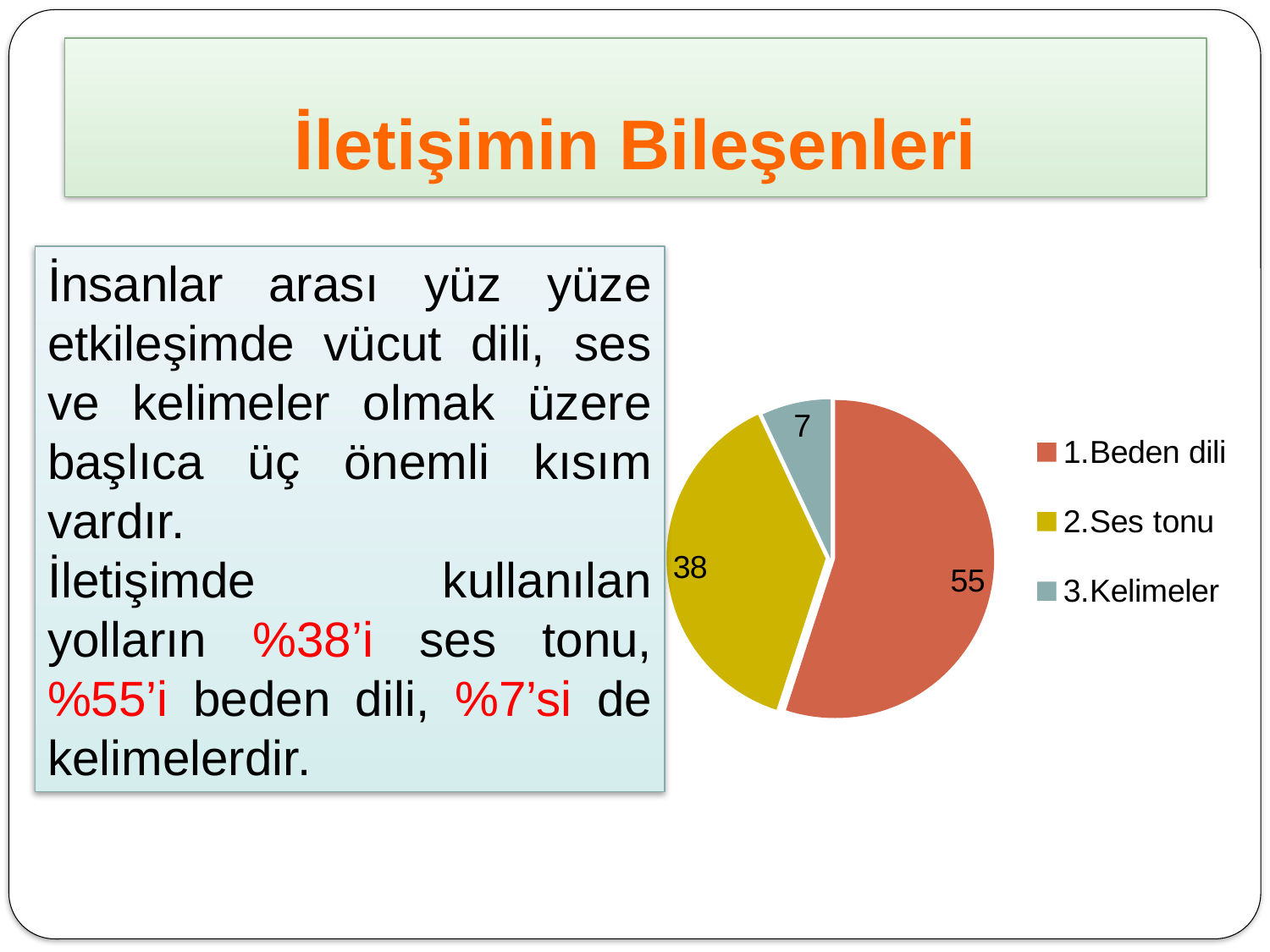
What is the difference between the values for 2.Ses tonu and 3.Kelimeler? 31 Which category has the largest slice in the pie chart? 1.Beden dili What is the value for 3.Kelimeler in the pie chart? 7 What kind of chart is shown on the slide? pie chart What is the value for 1.Beden dili in the pie chart? 55 What share of the pie does the 1.Beden dili slice represent? 55% Which category has the smallest slice in the pie chart? 3.Kelimeler Which colour represents 2.Ses tonu in the pie chart? yellow What is the value for 2.Ses tonu in the pie chart? 38 How many slices does the pie chart have? 3 What is the difference between the values for 1.Beden dili and 2.Ses tonu? 17 Which is larger, the value for 2.Ses tonu or the value for 3.Kelimeler? 2.Ses tonu